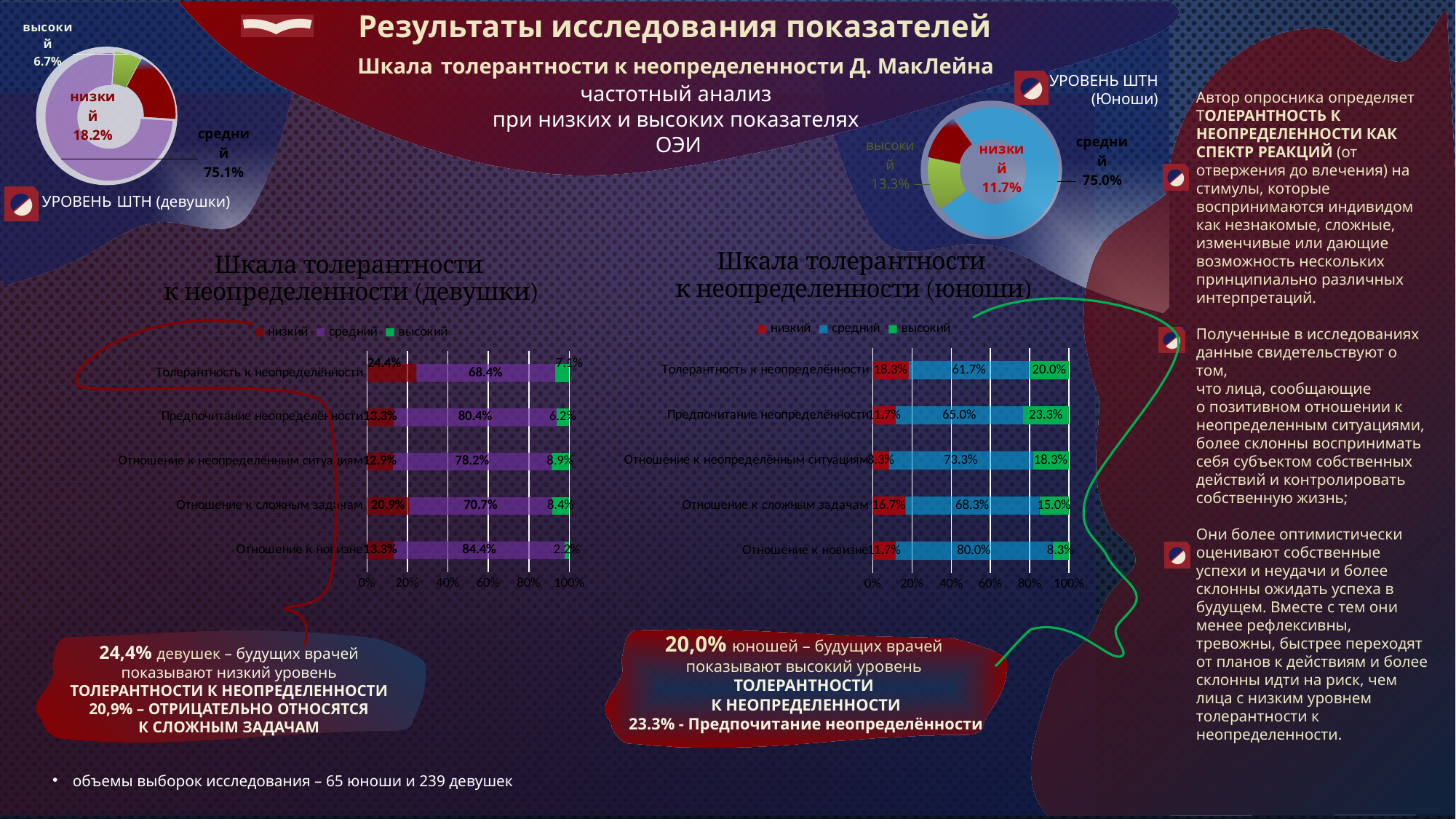
In the 'Шкала толерантности к неопределенности (юноши)' bar chart, what is the 'высокий' value for 'Предпочитание неопределённости'? 23.3% How many series does the legend of the 'Шкала толерантности к неопределенности (девушки)' bar chart list? 3 In the 'Шкала толерантности к неопределенности (девушки)' bar chart, which category has the highest 'низкий' value? Толерантность к неопределённости How many categories are shown in the 'Шкала толерантности к неопределенности (юноши)' bar chart? 5 In the 'Шкала толерантности к неопределенности (юноши)' bar chart, which is larger: the 'высокий' value for 'Толерантность к неопределённости' or for 'Отношение к новизне'? Толерантность к неопределённости In the 'Шкала толерантности к неопределенности (девушки)' bar chart, what is the difference between the 'низкий' values for 'Толерантность к неопределённости' and 'Отношение к сложным задачам'? 3.5% In the 'Шкала толерантности к неопределенности (юноши)' bar chart, what colour represents the 'средний' series? Blue In the 'Шкала толерантности к неопределенности (юноши)' bar chart, which category has the lowest 'низкий' value? Отношение к неопределённым ситуациям What type of chart is 'УРОВЕНЬ ШТН (девушки)'? Donut (pie) chart In the 'УРОВЕНЬ ШТН (девушки)' donut chart, what share is labelled 'средний'? 75.1% In the 'Шкала толерантности к неопределенности (девушки)' bar chart, what is the 'средний' value for 'Отношение к новизне'? 84.4% In the 'УРОВЕНЬ ШТН (Юноши)' donut chart, what share is labelled 'высокий'? 13.3%